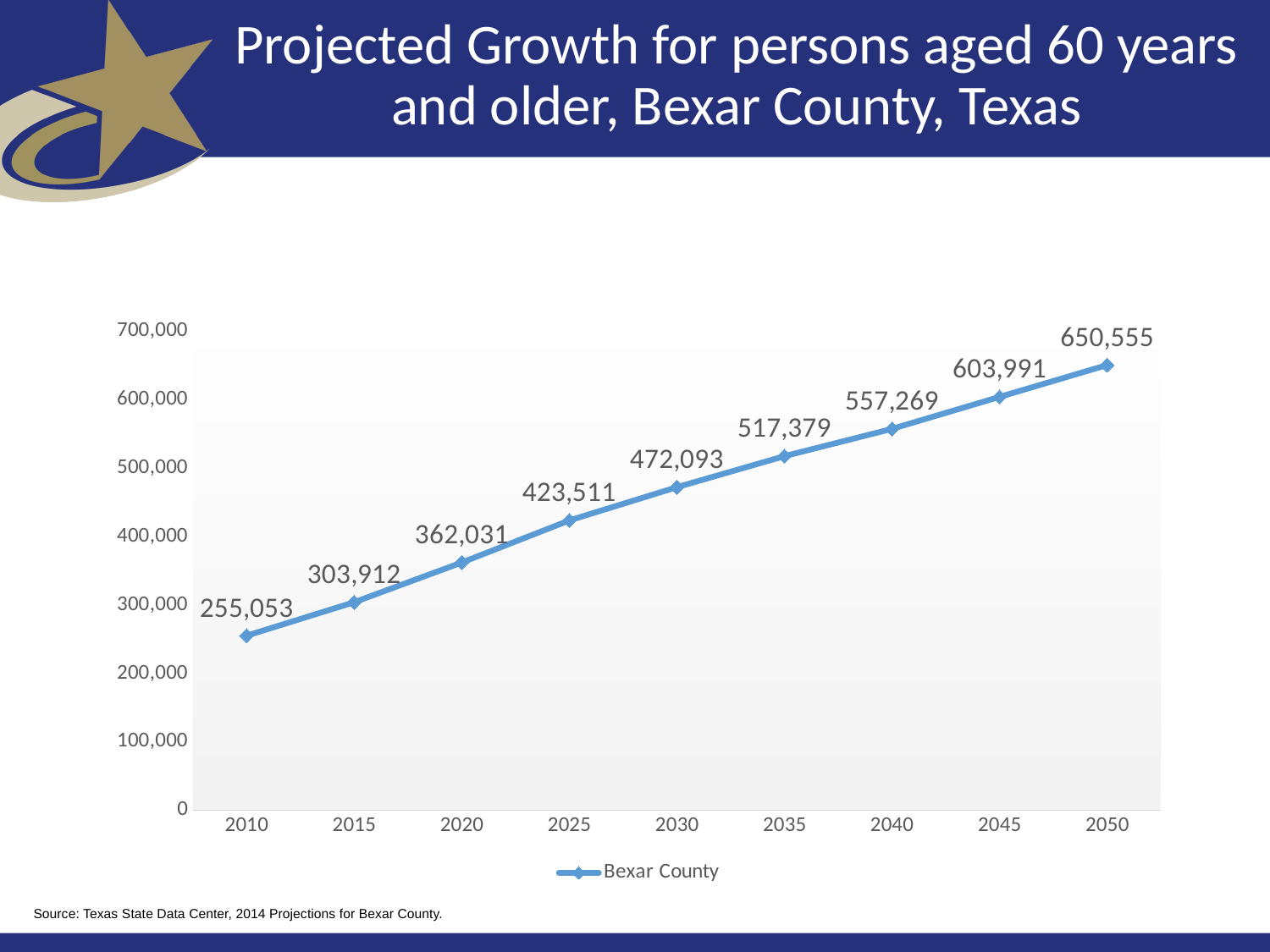
Do the values rise or fall from 2010 to 2050? rise How many years are plotted on the x axis? 9 What is the difference between the projected values for 2050 and 2010? 395,502 What kind of chart is shown? line chart Which year has the highest projected value? 2050 Which is larger, the value for 2035 or the value for 2040? 2040 What is the projected value for 2045? 603,991 What is the projected value for 2030? 472,093 What is the difference between the projected values for 2025 and 2020? 61,480 Which year has the lowest projected value? 2010 What is the projected value for 2010? 255,053 Is the value for 2020 greater or less than 400,000? less